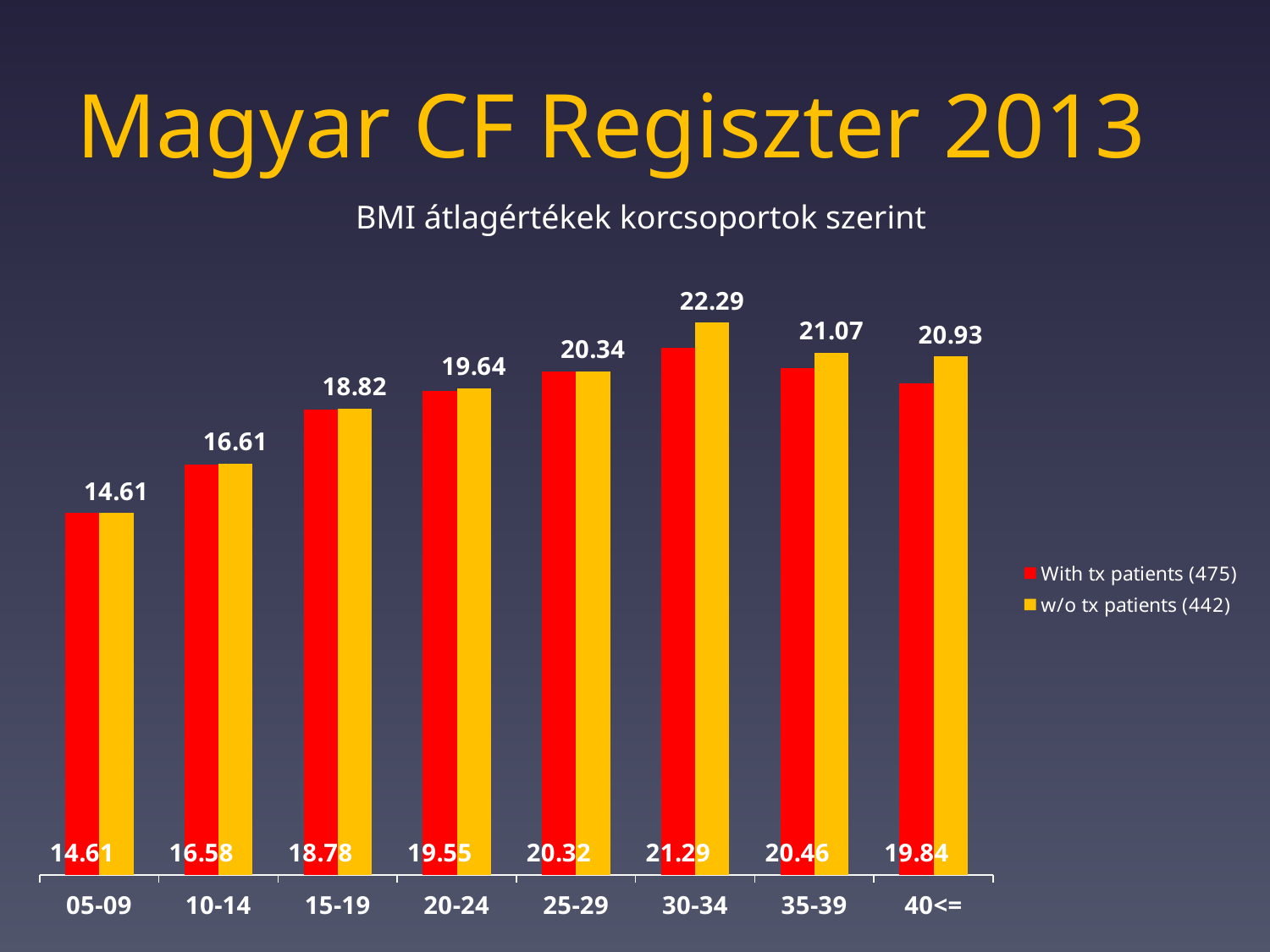
In the 40<= age group, which series has the larger value: 'With tx patients (475)' or 'w/o tx patients (442)'? w/o tx patients (442) What is the value for the 'With tx patients (475)' series in the 35-39 age group? 20.46 What is the title of the chart? BMI átlagértékek korcsoportok szerint What is the value for the 'With tx patients (475)' series in the 05-09 age group? 14.61 Which age group has the lowest value for the 'With tx patients (475)' series? 05-09 How many series does the legend list? 2 How many age groups are shown on the x axis? 8 What is the difference between the 'w/o tx patients (442)' and 'With tx patients (475)' values in the 30-34 age group? 1.00 What is the value for the 'w/o tx patients (442)' series in the 30-34 age group? 22.29 What is the value for the 'w/o tx patients (442)' series in the 40<= age group? 20.93 What kind of chart is shown on the slide? Bar chart Which age group has the highest value for the 'w/o tx patients (442)' series? 30-34